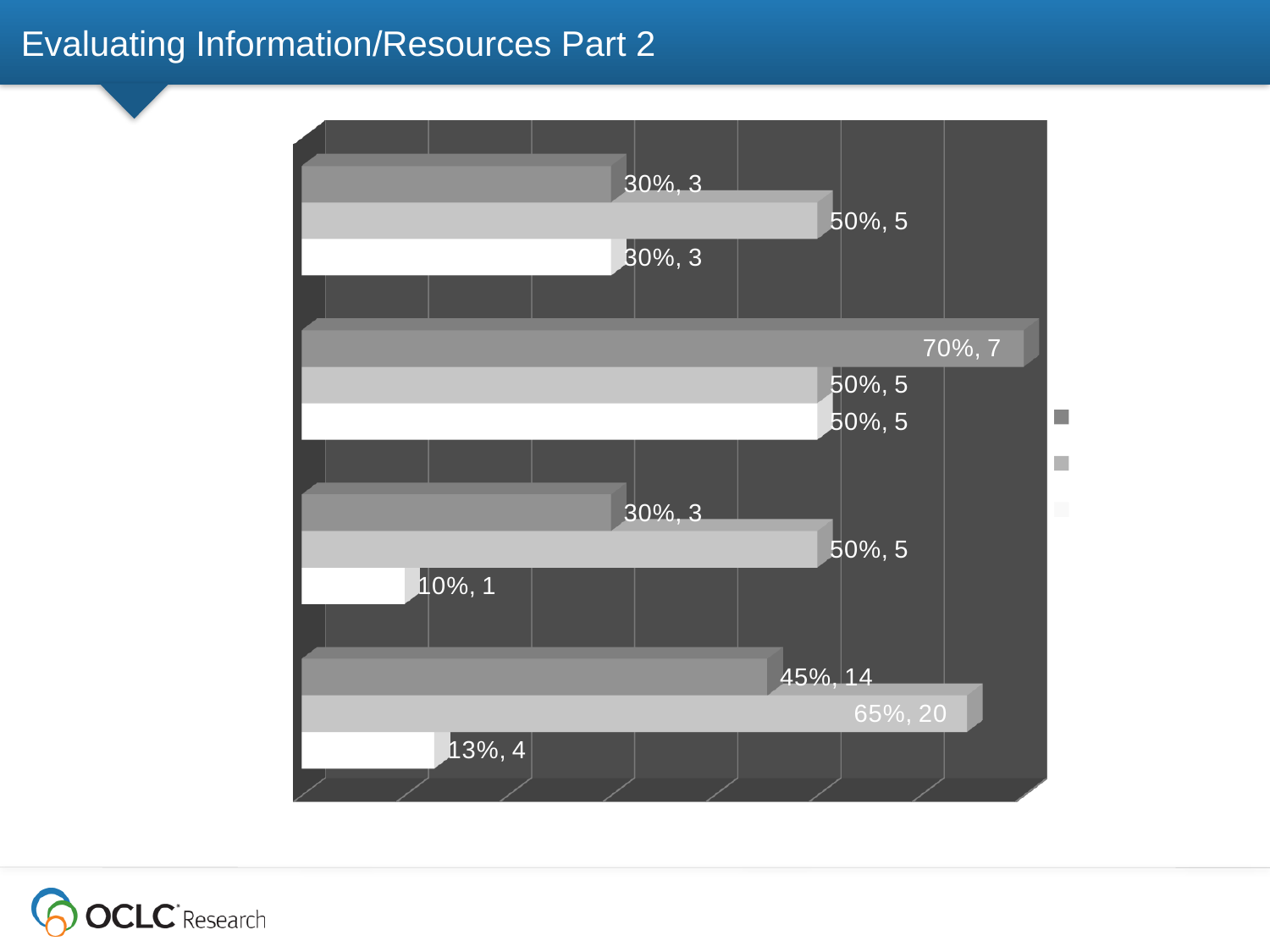
What is the data label on the dark gray bar in the second group from the top? 70%, 7 What kind of chart is shown on the slide? bar chart What is the data label on the white bar in the third group from the top? 10%, 1 In the top group, what is the data label on the light gray bar? 50%, 5 What is the data label on the light gray bar in the bottom group? 65%, 20 How many series does the legend on the right of the chart show? 3 How many groups of bars are plotted in the chart? 4 Which bar has the lowest percentage in the chart? the white bar in the third group from the top (10%, 1) In the bottom group, which is larger: the dark gray bar or the light gray bar? the light gray bar In the bottom group, what is the difference in count between the light gray bar (20) and the dark gray bar (14)? 6 Which bar has the highest percentage in the chart? the dark gray bar in the second group from the top (70%, 7) What is the data label on the white bar in the bottom group? 13%, 4